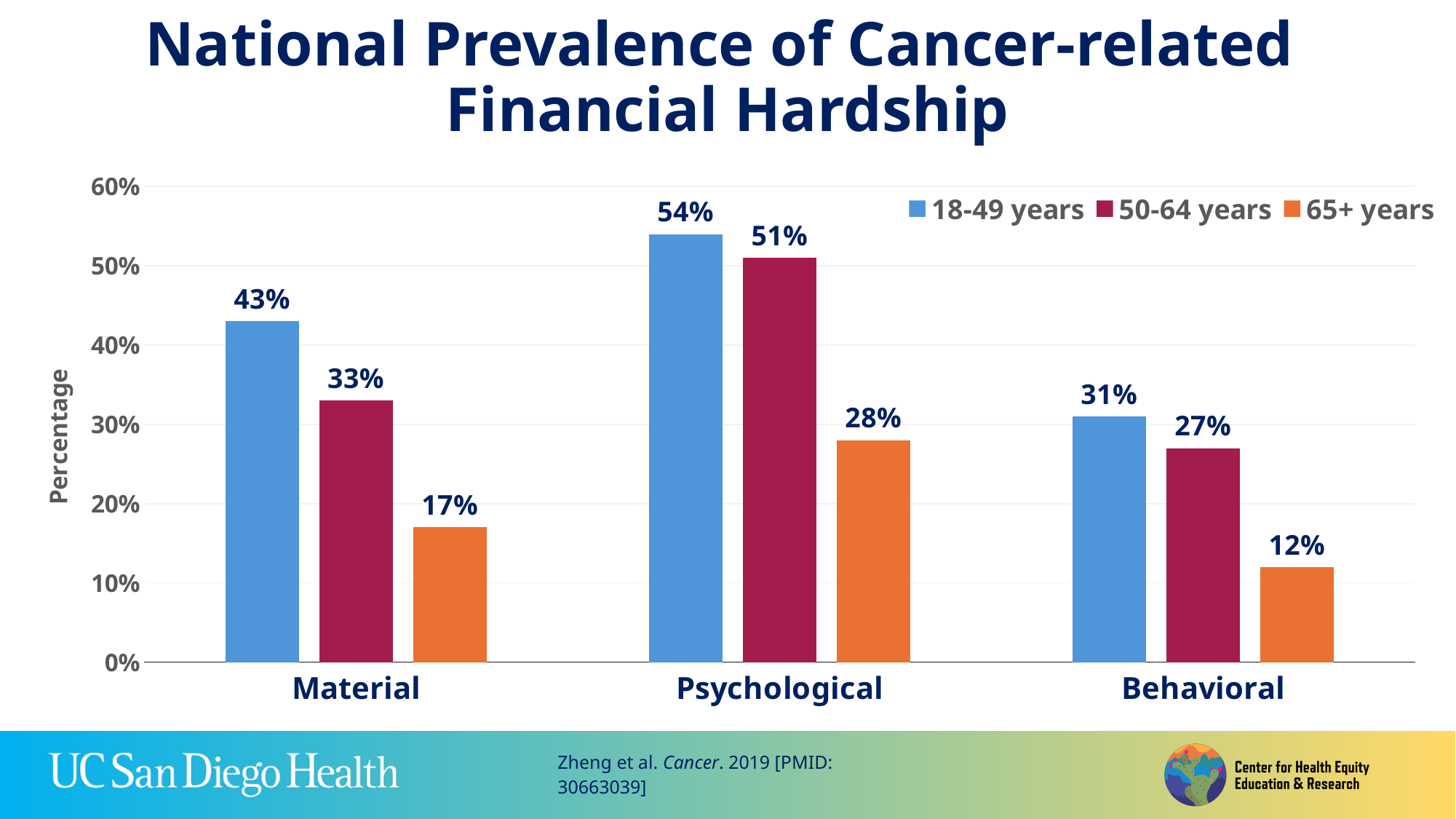
What is the label on the y axis? Percentage Which category has the highest value for the 18-49 years series? Psychological How many categories are shown on the x axis? 3 How many series does the legend list? 3 What is the title of the chart? National Prevalence of Cancer-related Financial Hardship Which is larger in the Psychological category: the 18-49 years value or the 50-64 years value? 18-49 years What is the value for the 65+ years series in the Psychological category? 28% What is the value for the 18-49 years series in the Material category? 43% What is the difference between the 18-49 years and 65+ years values in the Material category? 26% What is the value for the 50-64 years series in the Behavioral category? 27% Which category has the lowest value for the 65+ years series? Behavioral What kind of chart is shown on the slide? Bar chart